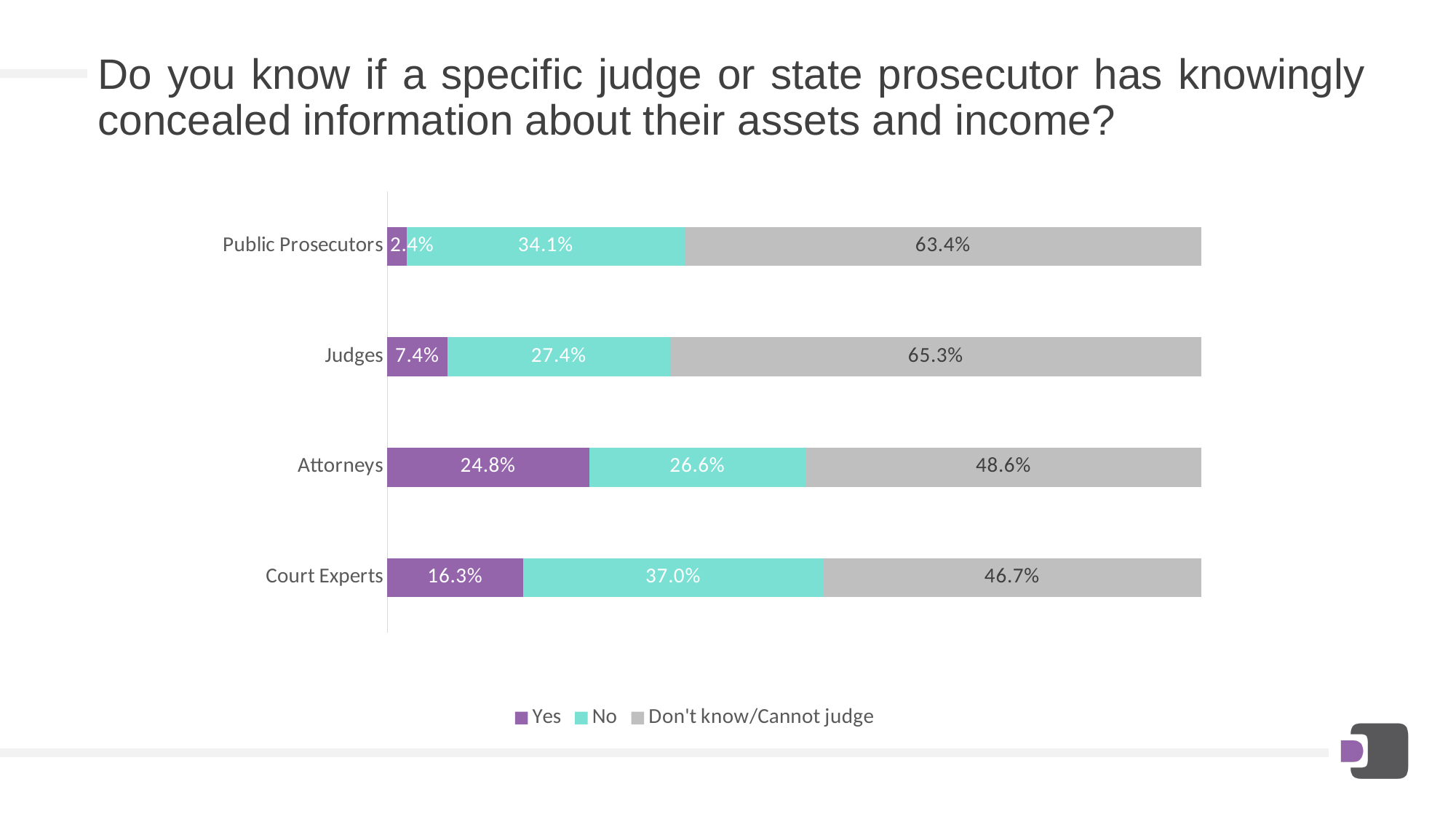
What kind of chart is shown on the slide? Stacked bar chart What percentage of Court Experts answered "No"? 37.0% Which is larger: the "No" share for Court Experts or for Attorneys? Court Experts Which group has the lowest share of "Yes" answers? Public Prosecutors Which group has the lowest share of "Don't know/Cannot judge" answers? Court Experts What is the difference in percentage points between the "Yes" share for Attorneys and for Judges? 17.4 How many groups are shown on the chart? 4 How many series does the legend list? 3 What is the total of the three segments in the Attorneys bar? 100.0% Which group has the highest share of "Yes" answers? Attorneys What percentage of Judges answered "Don't know/Cannot judge"? 65.3% What percentage of Public Prosecutors answered "Yes"? 2.4%